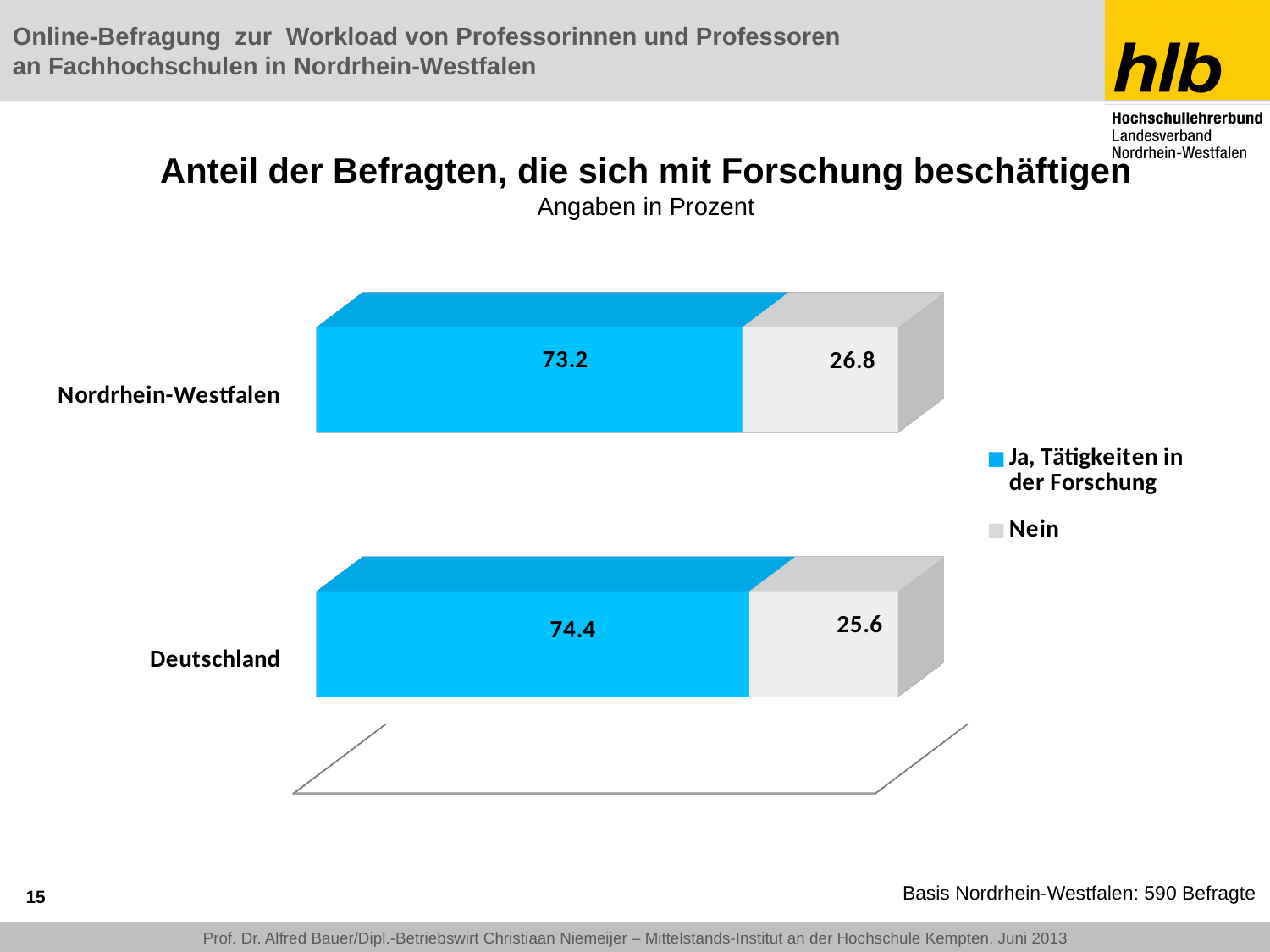
What is the total of the stacked bar for Nordrhein-Westfalen? 100 Which category has the higher value for "Ja, Tätigkeiten in der Forschung", Nordrhein-Westfalen or Deutschland? Deutschland What is the difference between the "Ja, Tätigkeiten in der Forschung" values for Deutschland and Nordrhein-Westfalen? 1.2 What is the value for "Ja, Tätigkeiten in der Forschung" for Deutschland? 74.4 What is the value for "Nein" for Nordrhein-Westfalen? 26.8 What kind of chart is shown on the slide? Stacked bar chart What is the value for "Nein" for Deutschland? 25.6 How many categories are shown on the chart? 2 How many series does the legend list? 2 What is the title of the chart? Anteil der Befragten, die sich mit Forschung beschäftigen What is the value for "Ja, Tätigkeiten in der Forschung" for Nordrhein-Westfalen? 73.2 What is the difference between the "Nein" values for Nordrhein-Westfalen and Deutschland? 1.2